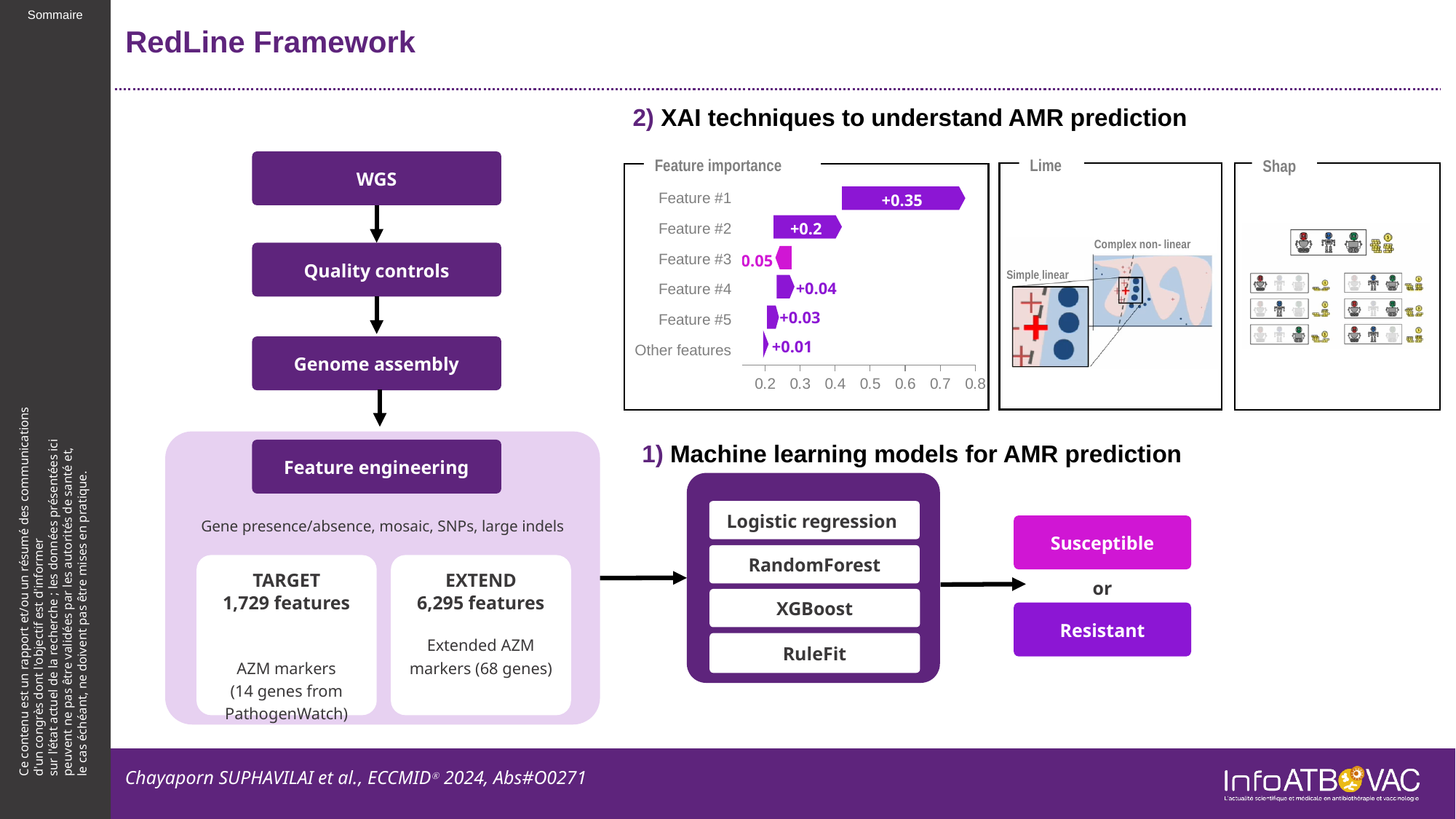
In the Feature importance chart, what is the value shown for Other features? +0.01 In the Feature importance chart, which feature has the highest importance value? Feature #1 In the Feature importance chart, what is the value shown for Feature #3? 0.05 How many categories are plotted in the Feature importance chart? 6 In the Feature importance chart, which category has the lowest value? Other features In the Feature importance chart, what is the value shown for Feature #2? +0.2 In the Feature importance chart, what is the value shown for Feature #1? +0.35 In the Feature importance chart, what is the difference between the values for Feature #1 and Feature #2? 0.15 What kind of chart is the Feature importance chart? Bar chart In the Feature importance chart, which has the larger value, Feature #2 or Feature #4? Feature #2 In the Feature importance chart, do the values increase or decrease going from Feature #1 down to Other features? Decrease In the Feature importance chart, what is the value shown for Feature #5? +0.03